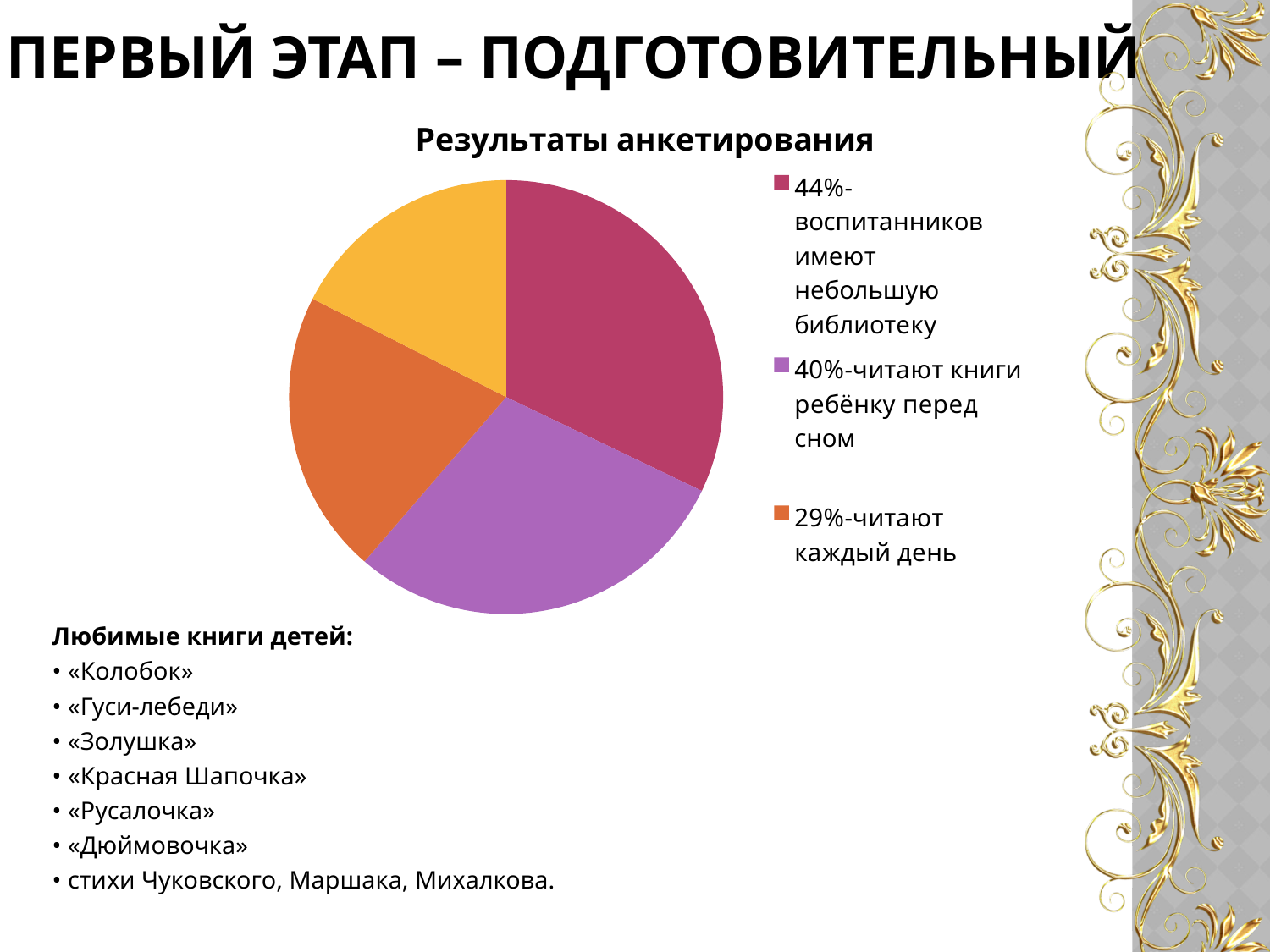
What is the title of the chart? Результаты анкетирования What colour is the slice for "29%-читают каждый день" in the legend? orange According to the legend, what percentage read every day? 29% According to the legend, what percentage read books to the child before bed? 40% According to the legend, what percentage of pupils have a small home library? 44% What is the difference between the legend values for having a small library (44%) and reading every day (29%)? 15% Which slice is larger: the red one (44%-воспитанников имеют небольшую библиотеку) or the purple one (40%-читают книги ребёнку перед сном)? the red one (44%-воспитанников имеют небольшую библиотеку) Which slice is larger: the red one (44%-воспитанников имеют небольшую библиотеку) or the yellow one? the red one Which legend entry corresponds to the largest slice of the pie? 44%-воспитанников имеют небольшую библиотеку How many slices does the pie chart have? 4 How many entries does the chart legend list? 3 What kind of chart is shown on the slide? pie chart